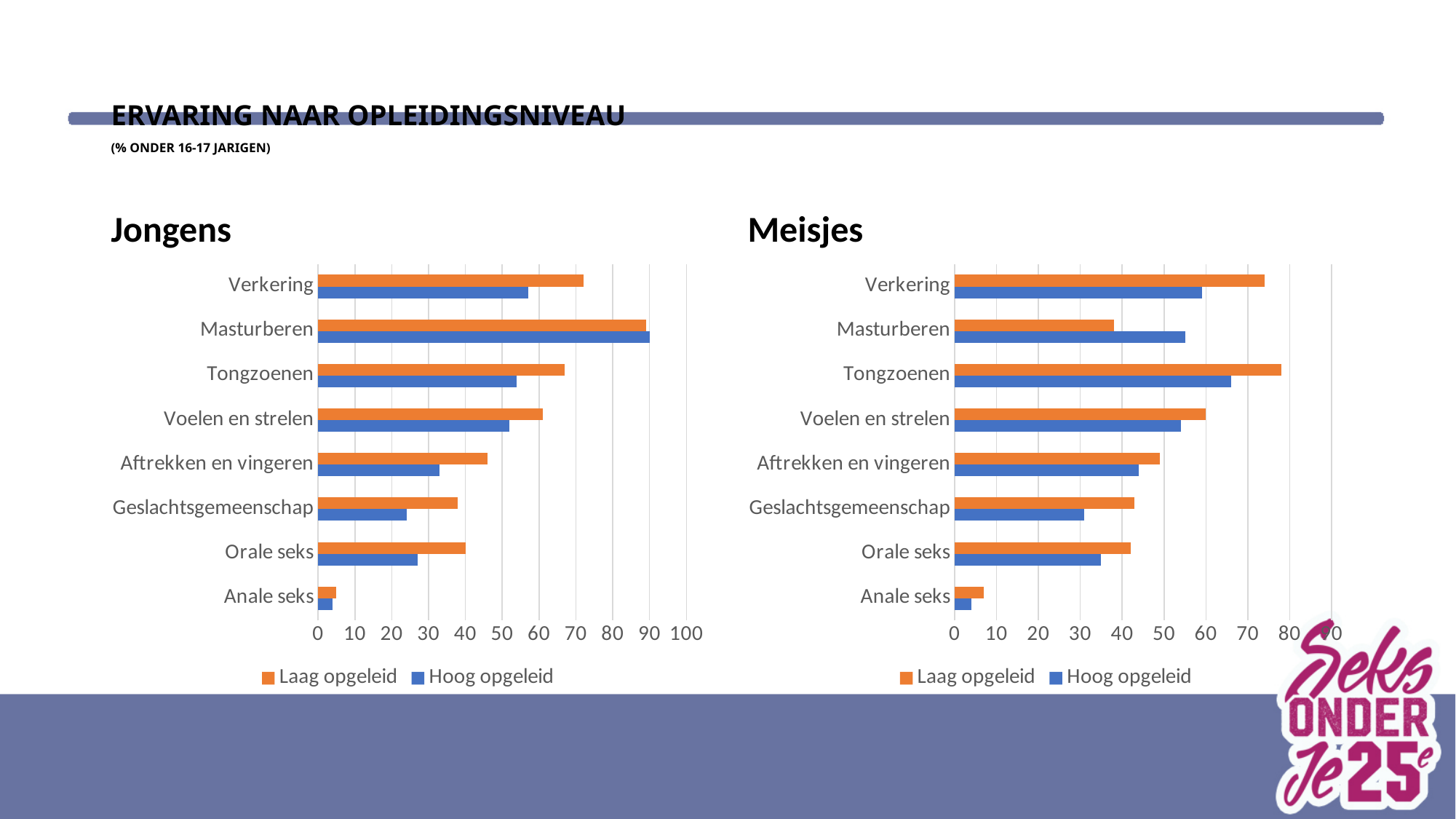
What kind of chart is the Jongens chart? bar chart On the Jongens chart, is the value for Geslachtsgemeenschap (Hoog opgeleid) greater or less than 30? less On the Jongens chart, which category has the highest value for Laag opgeleid? Masturberen On the Meisjes chart, which category has the highest value for Laag opgeleid? Tongzoenen How many series does the legend of the Jongens chart list? 2 On the Meisjes chart, which category has the lowest value for Laag opgeleid? Anale seks On the Meisjes chart, is the value for Tongzoenen (Laag opgeleid) greater or less than 70? greater On the Jongens chart, which colour represents Hoog opgeleid? blue On the Meisjes chart, for Masturberen, which is larger: Laag opgeleid or Hoog opgeleid? Hoog opgeleid How many categories are shown on the Meisjes chart? 8 On the Jongens chart, which category has the lowest value for Hoog opgeleid? Anale seks On the Jongens chart, for Verkering, which is larger: Laag opgeleid or Hoog opgeleid? Laag opgeleid